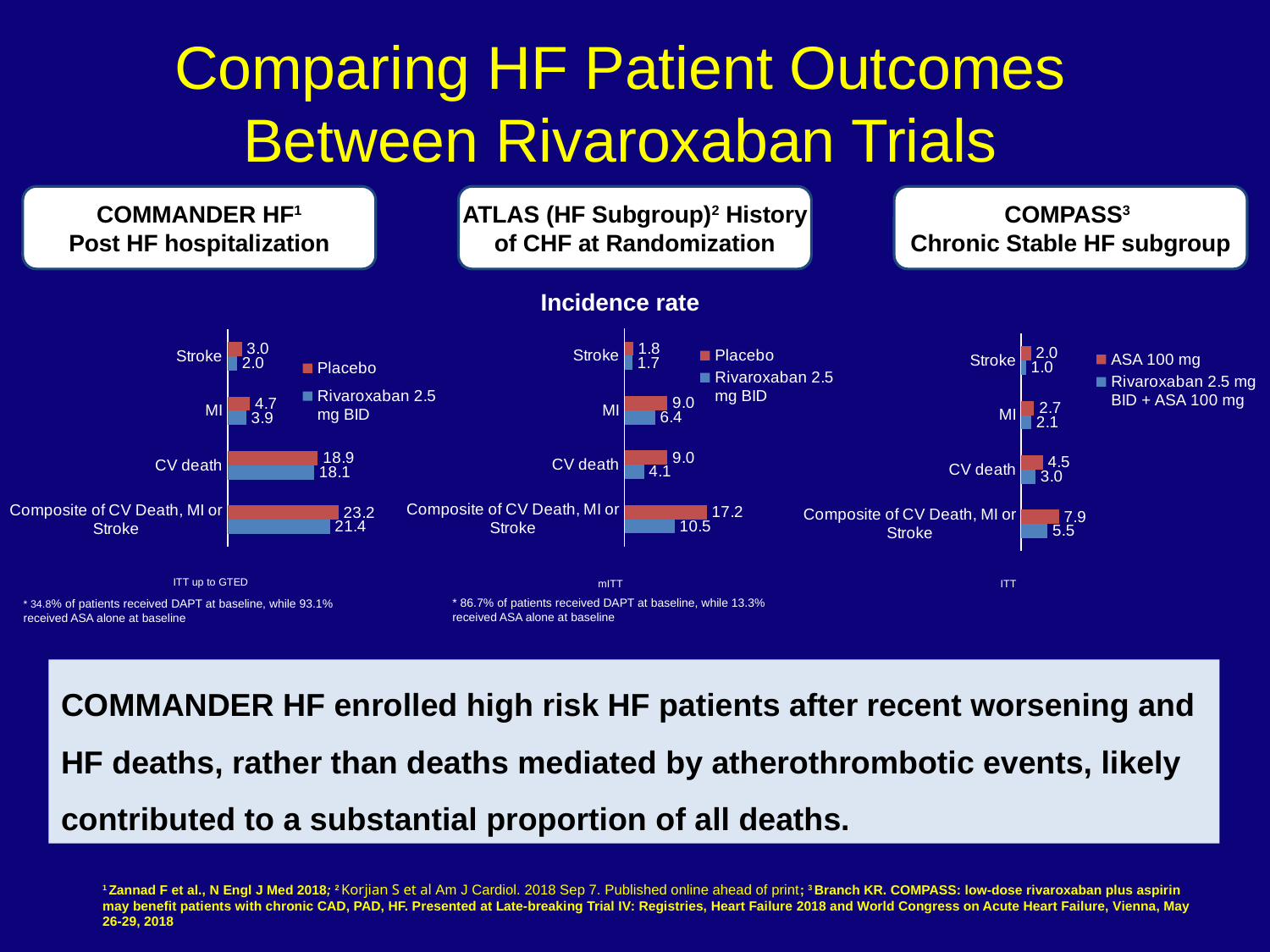
In the COMPASS chart (right), which is larger for CV death: the ASA 100 mg rate or the Rivaroxaban 2.5 mg BID + ASA 100 mg rate? ASA 100 mg How many outcome categories are shown in the COMMANDER HF chart (left)? 4 In the ATLAS (HF Subgroup) chart (middle), what is the difference between the Placebo and Rivaroxaban 2.5 mg BID rates for the Composite of CV Death, MI or Stroke? 6.7 In the ATLAS (HF Subgroup) chart (middle), what is the Rivaroxaban 2.5 mg BID incidence rate for CV death? 4.1 In the COMMANDER HF chart (left), what is the difference between the Placebo and Rivaroxaban 2.5 mg BID incidence rates for Stroke? 1.0 What type of chart is used for the ATLAS (HF Subgroup) data (middle)? Bar chart In the ATLAS (HF Subgroup) chart (middle), which outcome has the highest Placebo incidence rate? Composite of CV Death, MI or Stroke How many series does the legend of the COMPASS chart (right) list? 2 In the COMPASS chart (right), what is the ASA 100 mg incidence rate for MI? 2.7 In the COMMANDER HF chart (left), what is the Placebo incidence rate for CV death? 18.9 In the COMMANDER HF chart (left), what is the Rivaroxaban 2.5 mg BID incidence rate for the Composite of CV Death, MI or Stroke? 21.4 In the COMPASS chart (right), which outcome has the lowest Rivaroxaban 2.5 mg BID + ASA 100 mg incidence rate? Stroke